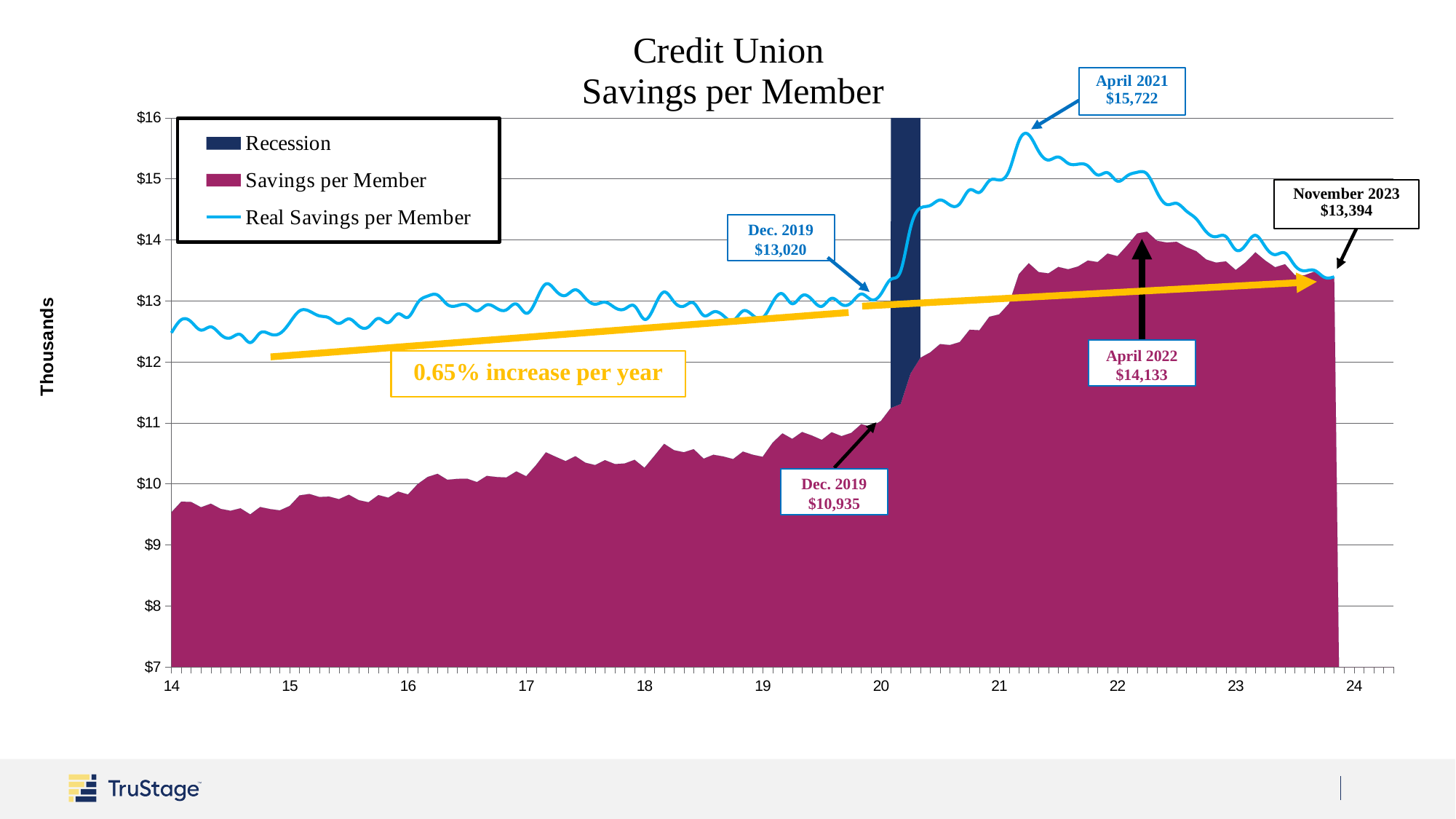
What value is annotated for November 2023? $13,394 Does Savings per Member generally rise or fall from 2014 to 2022? rise Which is larger: the April 2021 Real Savings per Member value or the April 2022 Savings per Member value? April 2021 Real Savings per Member ($15,722) What is the Savings per Member value annotated for Dec. 2019? $10,935 How much did Savings per Member increase from Dec. 2019 ($10,935) to April 2022 ($14,133)? $3,198 What is the Savings per Member value annotated for April 2022? $14,133 What is the Real Savings per Member value annotated for April 2021? $15,722 Is the Savings per Member value at the start of 2014 greater or less than $10 thousand? less What is the Real Savings per Member value annotated for Dec. 2019? $13,020 What annual rate of increase is labelled on the trend arrow? 0.65% increase per year How many entries does the legend list? 3 In Dec. 2019, how much higher is Real Savings per Member ($13,020) than Savings per Member ($10,935)? $2,085